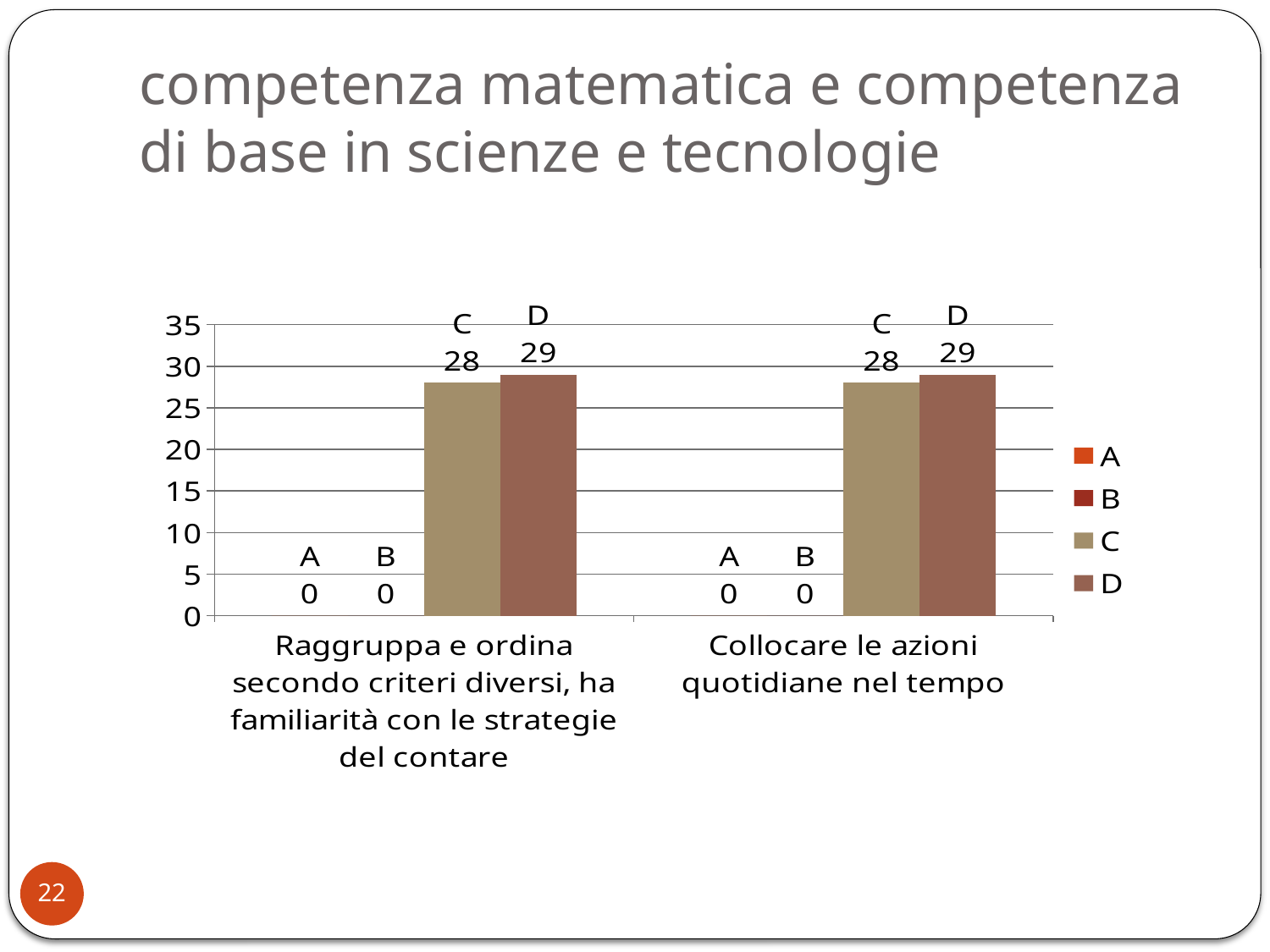
What is the value for series A in the category "Collocare le azioni quotidiane nel tempo"? 0 What is the maximum value shown on the vertical axis? 35 What is the title of the slide containing the chart? competenza matematica e competenza di base in scienze e tecnologie Which series has the highest value in the category "Raggruppa e ordina secondo criteri diversi, ha familiarità con le strategie del contare"? D What is the total of the values for series A, B, C and D in the category "Collocare le azioni quotidiane nel tempo"? 57 Is the value for series C in "Collocare le azioni quotidiane nel tempo" greater or less than 25? greater How many series does the legend list? 4 What is the value for series D in the category "Raggruppa e ordina secondo criteri diversi, ha familiarità con le strategie del contare"? 29 What kind of chart is shown on the slide? bar chart What is the difference between the values of series D and series C in the category "Collocare le azioni quotidiane nel tempo"? 1 How many categories are shown on the x axis? 2 What is the value for series C in the category "Collocare le azioni quotidiane nel tempo"? 28